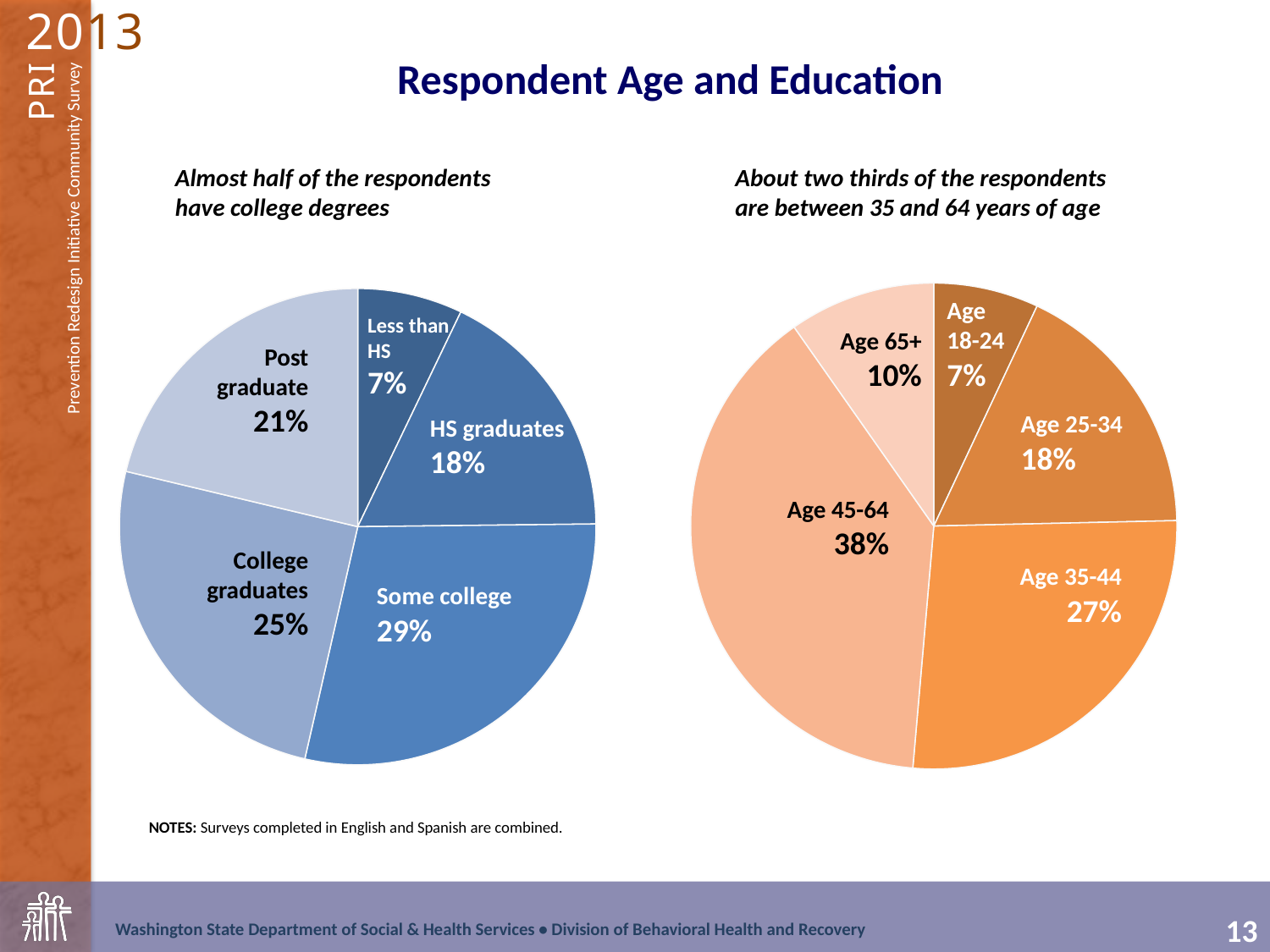
In the education pie chart on the left, which is larger: Post graduate or HS graduates? Post graduate What is the title of the slide containing the two charts? Respondent Age and Education What type of chart is used on the right to show respondent age? Pie chart In the age pie chart on the right, what is the difference in percentage points between Age 45-64 and Age 35-44? 11 In the education pie chart on the left, which category has the smallest share? Less than HS How many slices does the education pie chart on the left have? 5 In the age pie chart on the right, which age group has the largest share? Age 45-64 In the education pie chart on the left, which category has the largest share? Some college In the age pie chart on the right, what share of respondents are Age 45-64? 38% In the age pie chart on the right, which age group has the smallest share? Age 18-24 In the education pie chart on the left, what share of respondents are college graduates? 25% How many slices does the age pie chart on the right have? 5